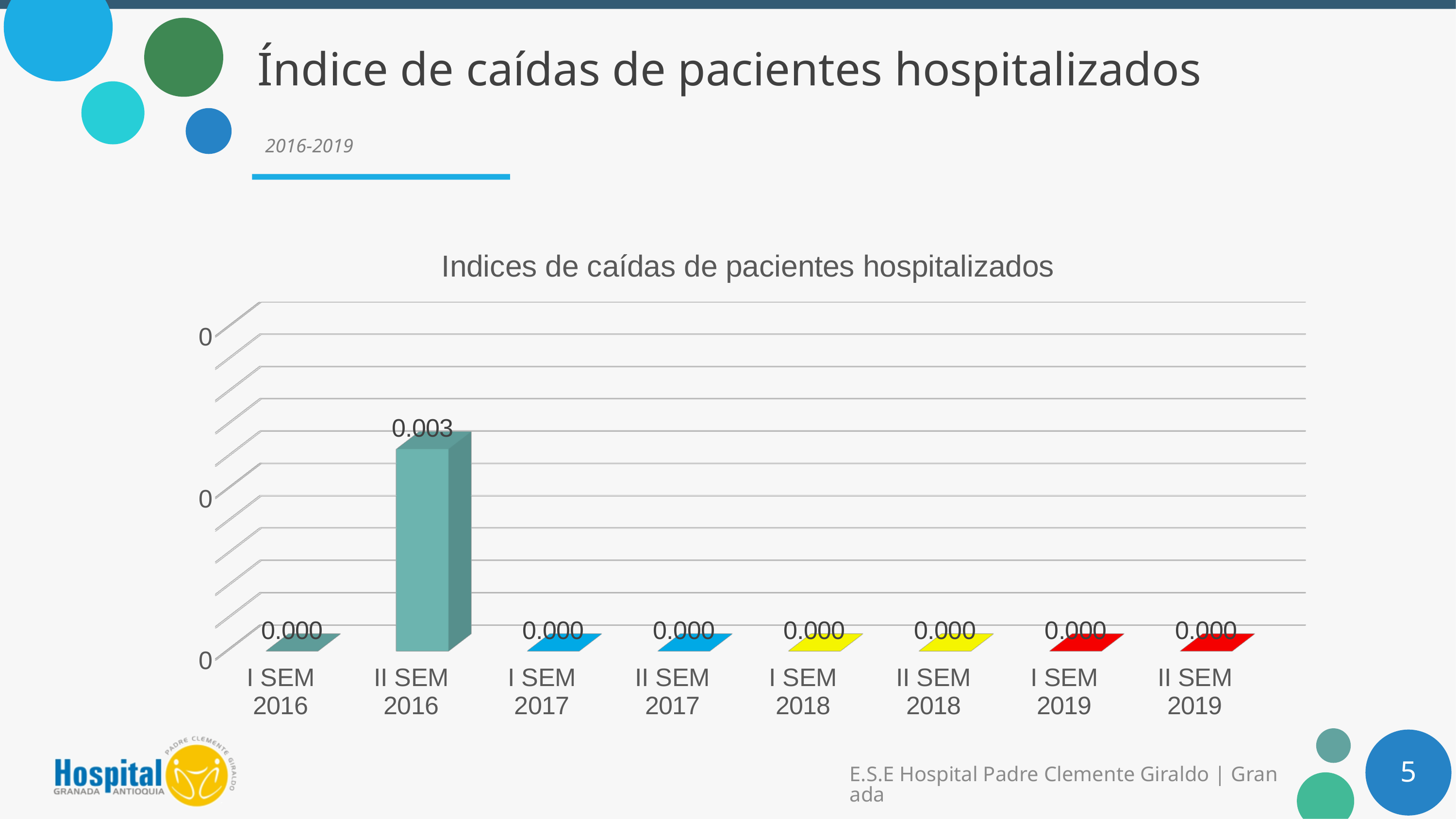
What colour are the bars for the 2018 semesters? Yellow What is the difference between the values for II SEM 2016 and I SEM 2017? 0.003 How many categories have a value of 0.000? 7 What kind of chart is shown on the slide? Bar chart What is the value for II SEM 2016? 0.003 Which is larger, the value for II SEM 2016 or the value for II SEM 2017? II SEM 2016 How many categories are shown on the x axis? 8 What is the value for I SEM 2018? 0.000 What is the title of the chart? Indices de caídas de pacientes hospitalizados Which category has the highest value? II SEM 2016 What is the value for I SEM 2016? 0.000 What is the value for II SEM 2019? 0.000